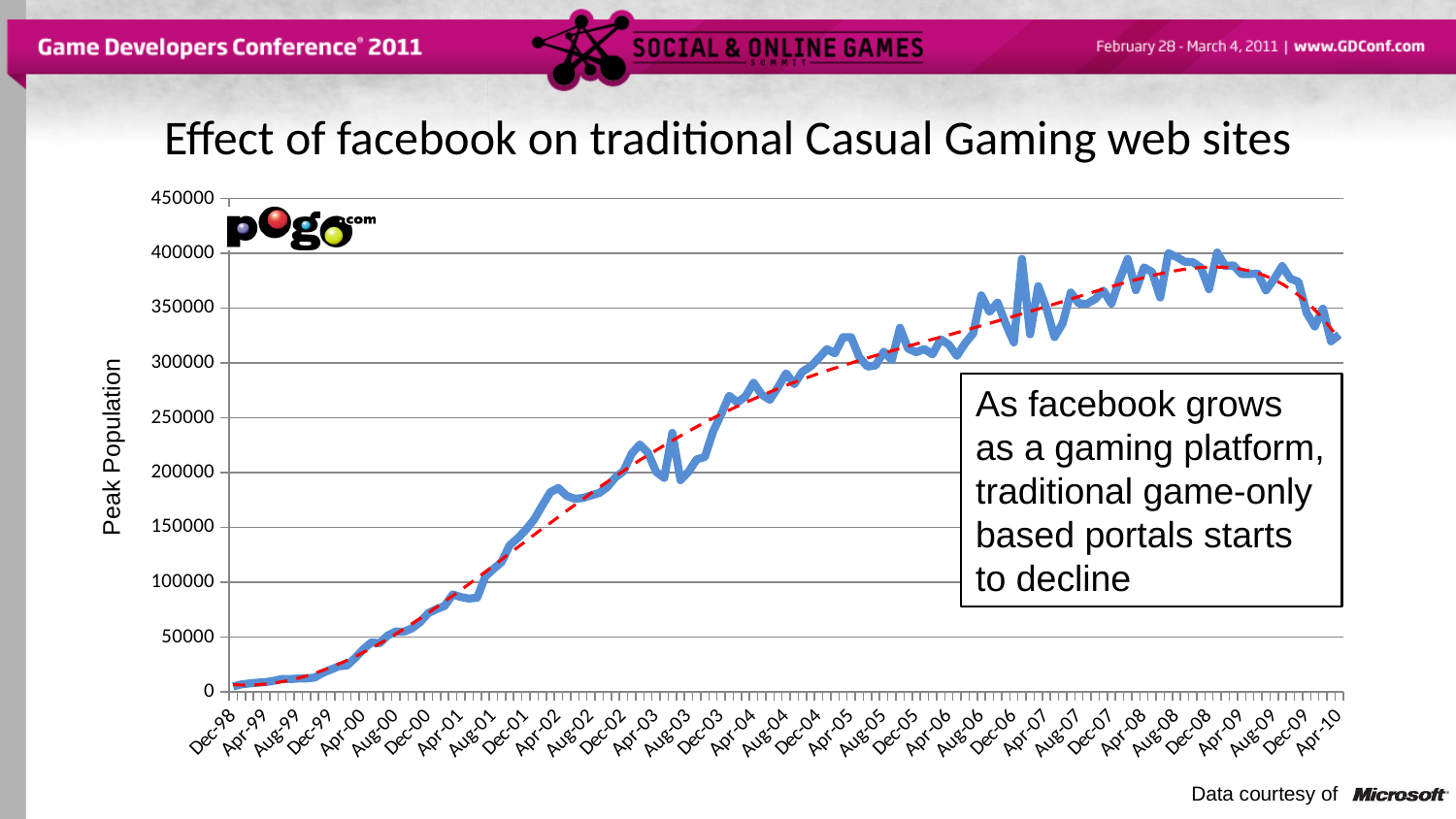
What kind of chart is shown on the slide? Line chart Is the value for Apr-02 greater or less than 150000? greater Does the peak population rise or fall between Dec-98 and Dec-08? Rise Which is larger, the value for Apr-10 or the value for Apr-99? Apr-10 Is the value for Aug-08 greater or less than 350000? greater Is the value for Dec-98 greater or less than 50000? less Does the peak population rise or fall between Dec-08 and Apr-10? Fall What is the title of the chart on the slide? Effect of facebook on traditional Casual Gaming web sites What is the label on the vertical axis of the chart? Peak Population